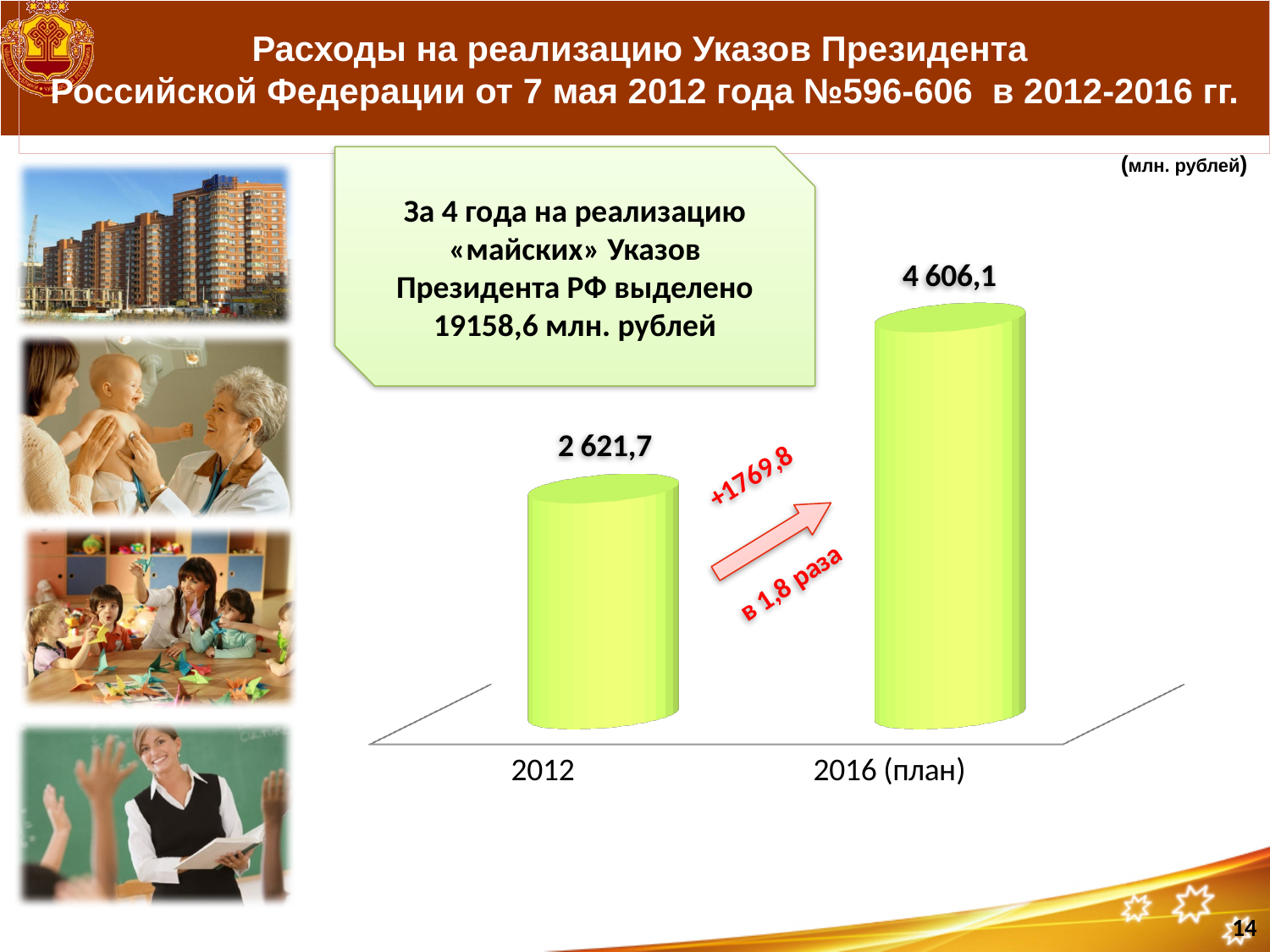
What kind of chart is shown on the slide? bar chart What is the value for 2016 (план)? 4 606,1 In what units are the chart values given? млн. рублей How many categories are shown on the chart? 2 Which category has the highest value? 2016 (план) Which category has the lowest value? 2012 What is the value for 2012? 2 621,7 Do the values rise or fall from 2012 to 2016 (план)? rise What growth factor is written next to the arrow between the two bars? в 1,8 раза Which is larger, the value for 2012 or the value for 2016 (план)? 2016 (план)